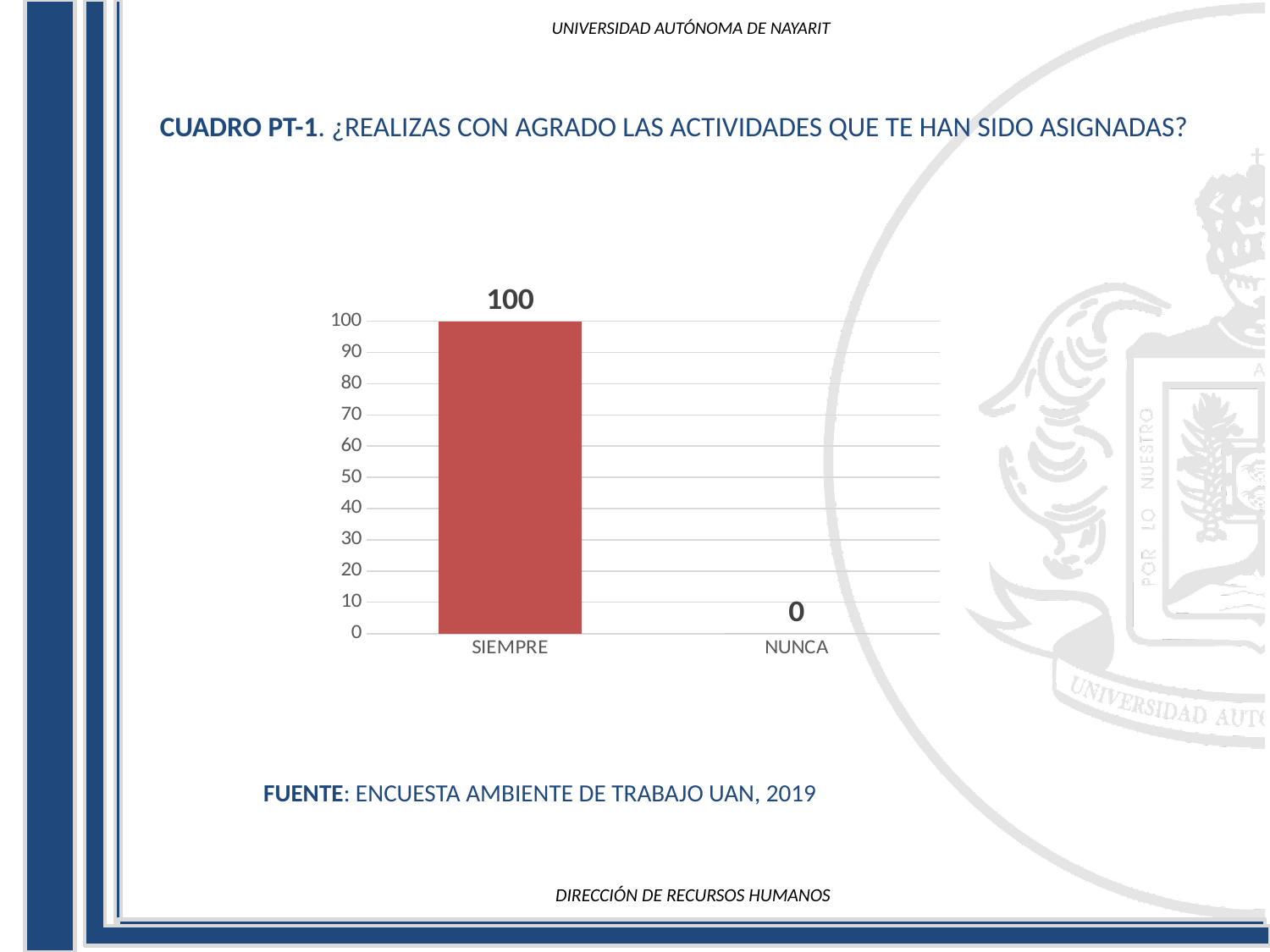
What is the source cited below the chart? ENCUESTA AMBIENTE DE TRABAJO UAN, 2019 Which category has the lowest value? NUNCA What kind of chart is shown on the slide? bar chart What is the value for SIEMPRE? 100 What is the value for NUNCA? 0 Which category has the highest value? SIEMPRE How many categories are shown on the x axis? 2 What is the difference between the values for SIEMPRE and NUNCA? 100 Do the values rise or fall from SIEMPRE to NUNCA? fall Is the value for SIEMPRE greater or less than 50? greater Which is larger, the value for SIEMPRE or the value for NUNCA? SIEMPRE What is the total of the values for SIEMPRE and NUNCA? 100